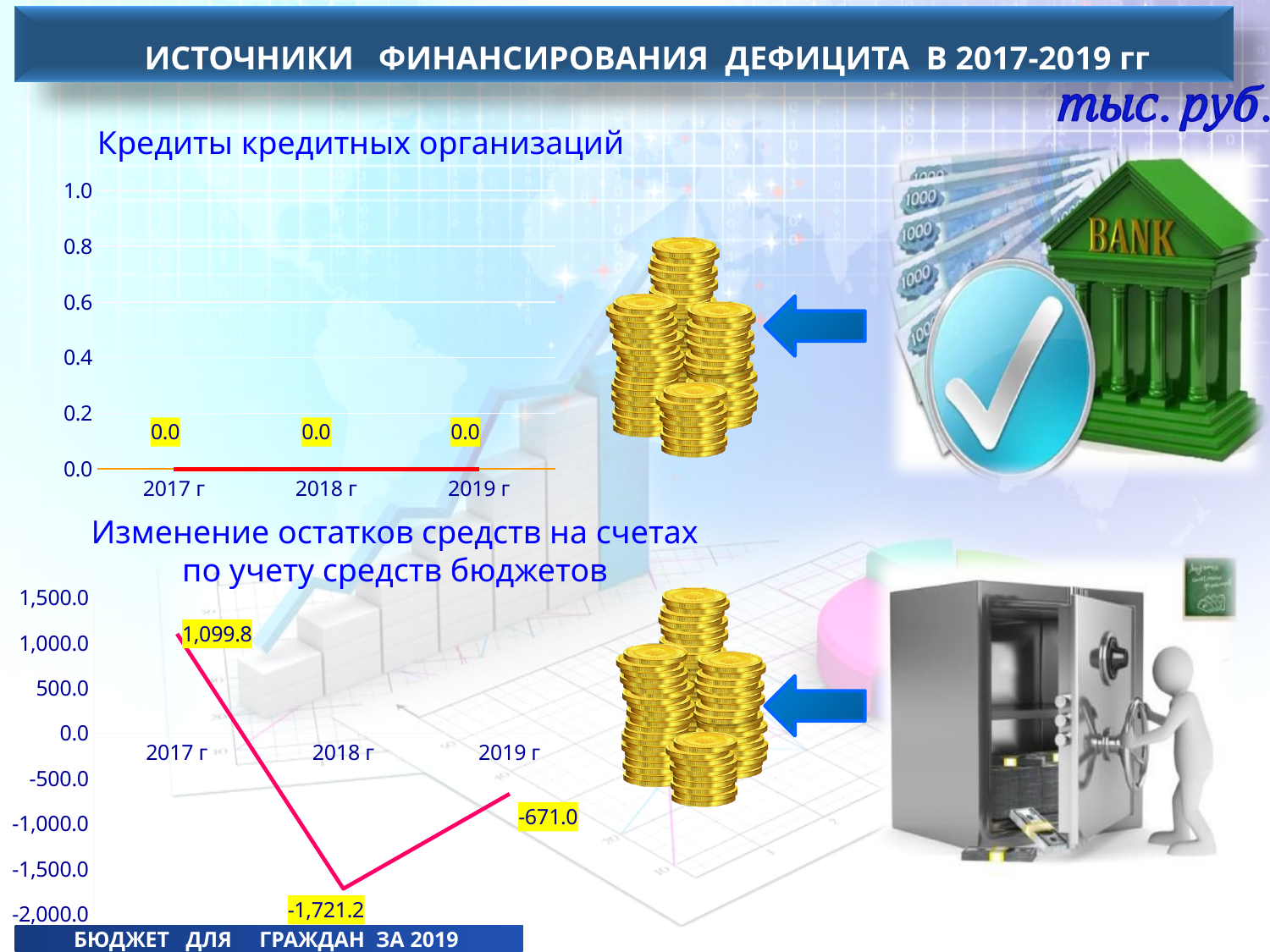
In the chart 'Изменение остатков средств на счетах по учету средств бюджетов', which year has the lowest value? 2018 г What unit is stated for the values on the slide? тыс. руб. In the chart 'Изменение остатков средств на счетах по учету средств бюджетов', what is the value for 2017 г? 1,099.8 In the chart 'Изменение остатков средств на счетах по учету средств бюджетов', which is larger: the value for 2018 г or the value for 2019 г? 2019 г In the chart 'Изменение остатков средств на счетах по учету средств бюджетов', is the value for 2018 г greater or less than -1,500.0? less In the chart 'Изменение остатков средств на счетах по учету средств бюджетов', which year has the highest value? 2017 г In the chart 'Изменение остатков средств на счетах по учету средств бюджетов', what is the value for 2019 г? -671.0 What kind of chart is 'Кредиты кредитных организаций'? line chart In the chart 'Изменение остатков средств на счетах по учету средств бюджетов', what is the value for 2018 г? -1,721.2 In the chart 'Изменение остатков средств на счетах по учету средств бюджетов', what is the difference between the values for 2017 г and 2019 г? 1,770.8 In the chart 'Кредиты кредитных организаций', how many years are plotted? 3 In the chart 'Кредиты кредитных организаций', what is the value for 2018 г? 0.0